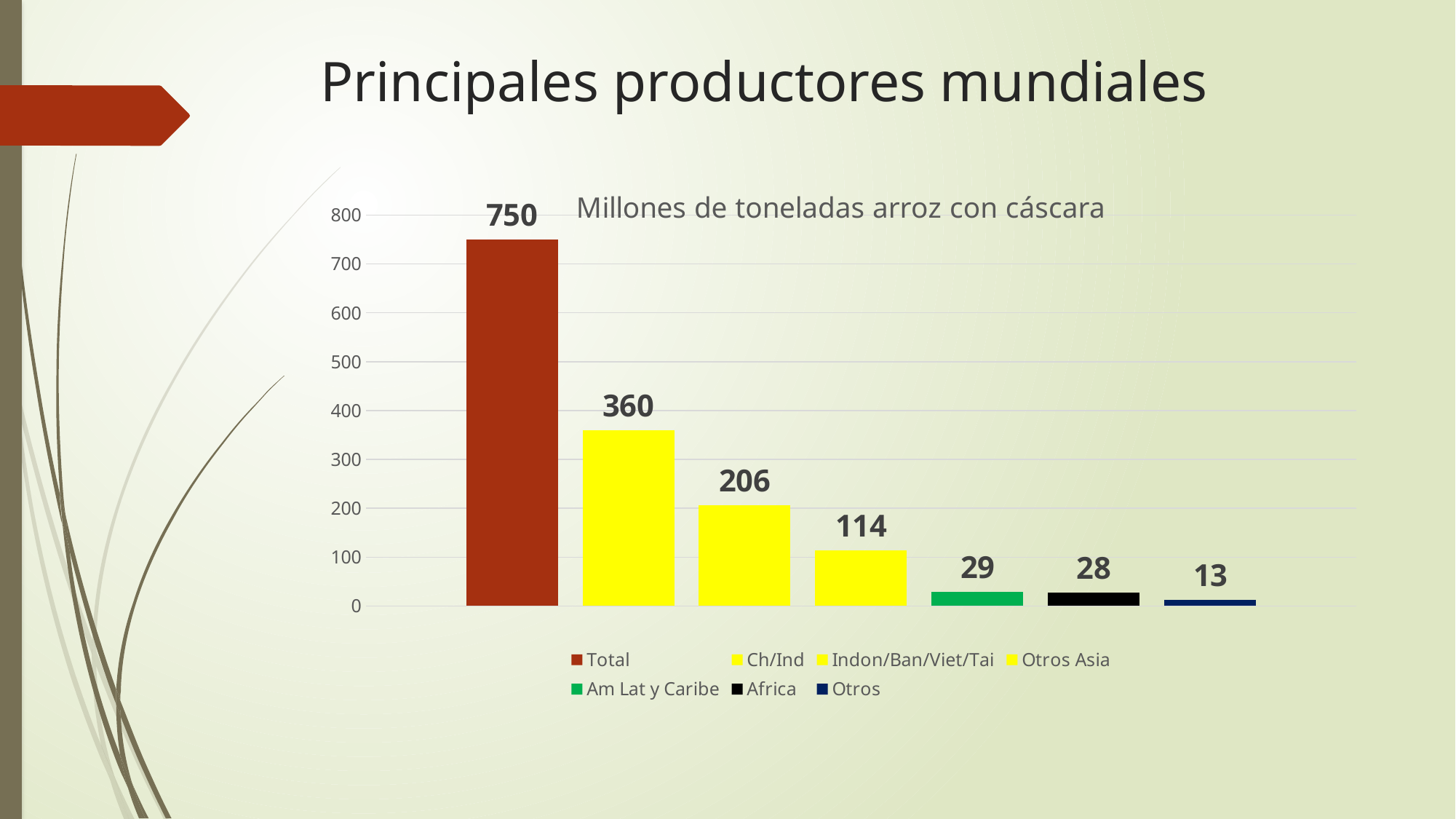
How many bars are plotted in the chart? 7 What is the title of the chart? Millones de toneladas arroz con cáscara What kind of chart is shown on the slide? bar chart Which is larger, the value for Indon/Ban/Viet/Tai or the value for Otros Asia? Indon/Ban/Viet/Tai What is the value for Africa? 28 What is the difference between the values for Ch/Ind and Indon/Ban/Viet/Tai? 154 What is the value for Otros Asia? 114 What is the value for Ch/Ind? 360 What is the difference between the values for Am Lat y Caribe and Otros? 16 Which category has the highest value? Total Which category has the lowest value? Otros Is the value for Ch/Ind greater or less than 300? greater